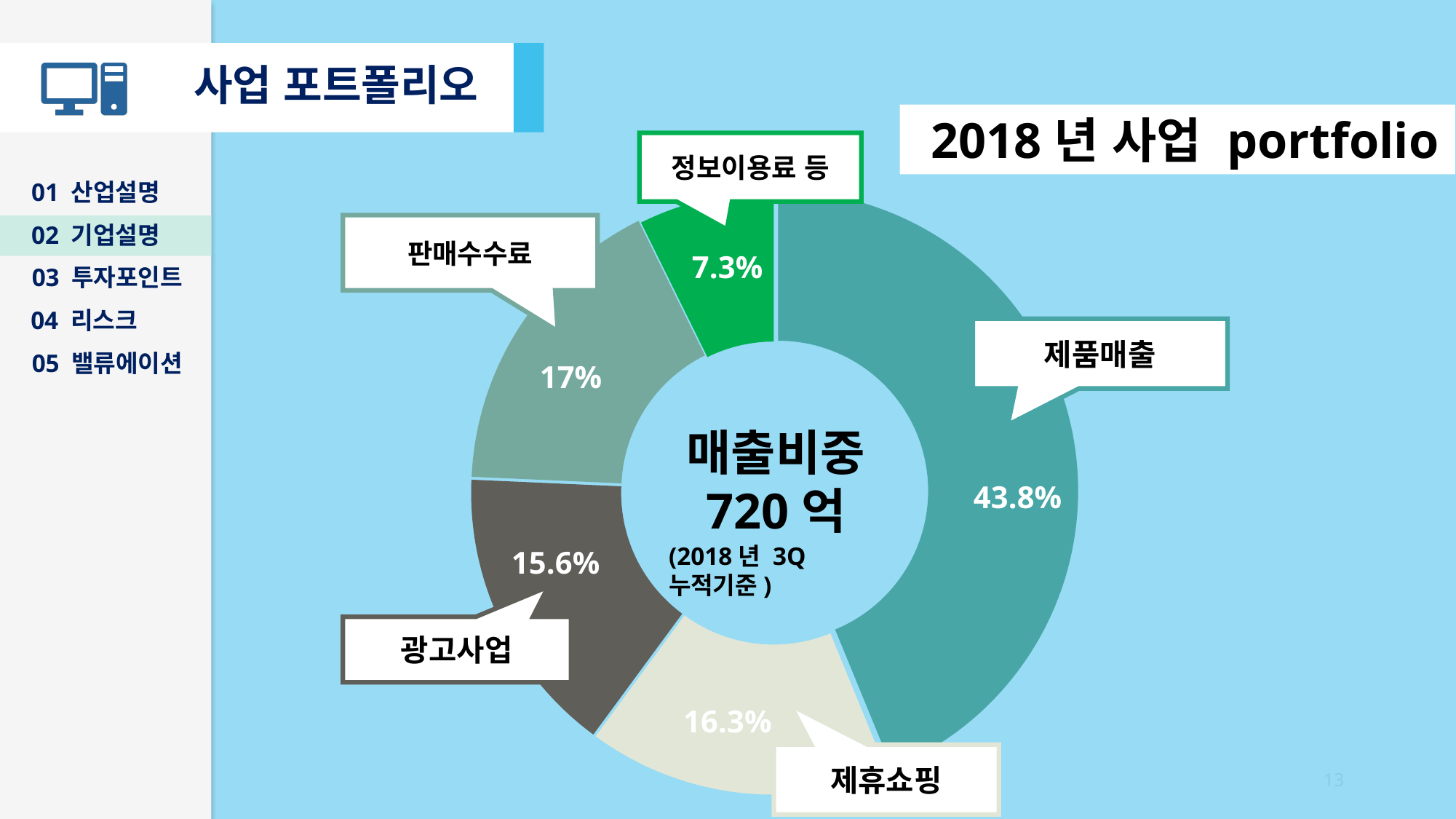
What kind of chart is shown on the slide? Pie chart (donut) How many categories are shown in the chart? 5 What is the value shown for 판매수수료? 17% Which is larger, the share of 제휴쇼핑 or the share of 광고사업? 제휴쇼핑 What is the value shown for 제휴쇼핑? 16.3% What share of the pie does 제품매출 account for? 43.8% Which category has the largest share of the chart? 제품매출 Which category has the smallest share of the chart? 정보이용료 등 What is the value shown for 광고사업? 15.6% What is the difference between the shares of 제품매출 and 판매수수료? 26.8% What is the value shown for 정보이용료 등? 7.3% What total revenue figure is written in the centre of the chart? 720 억